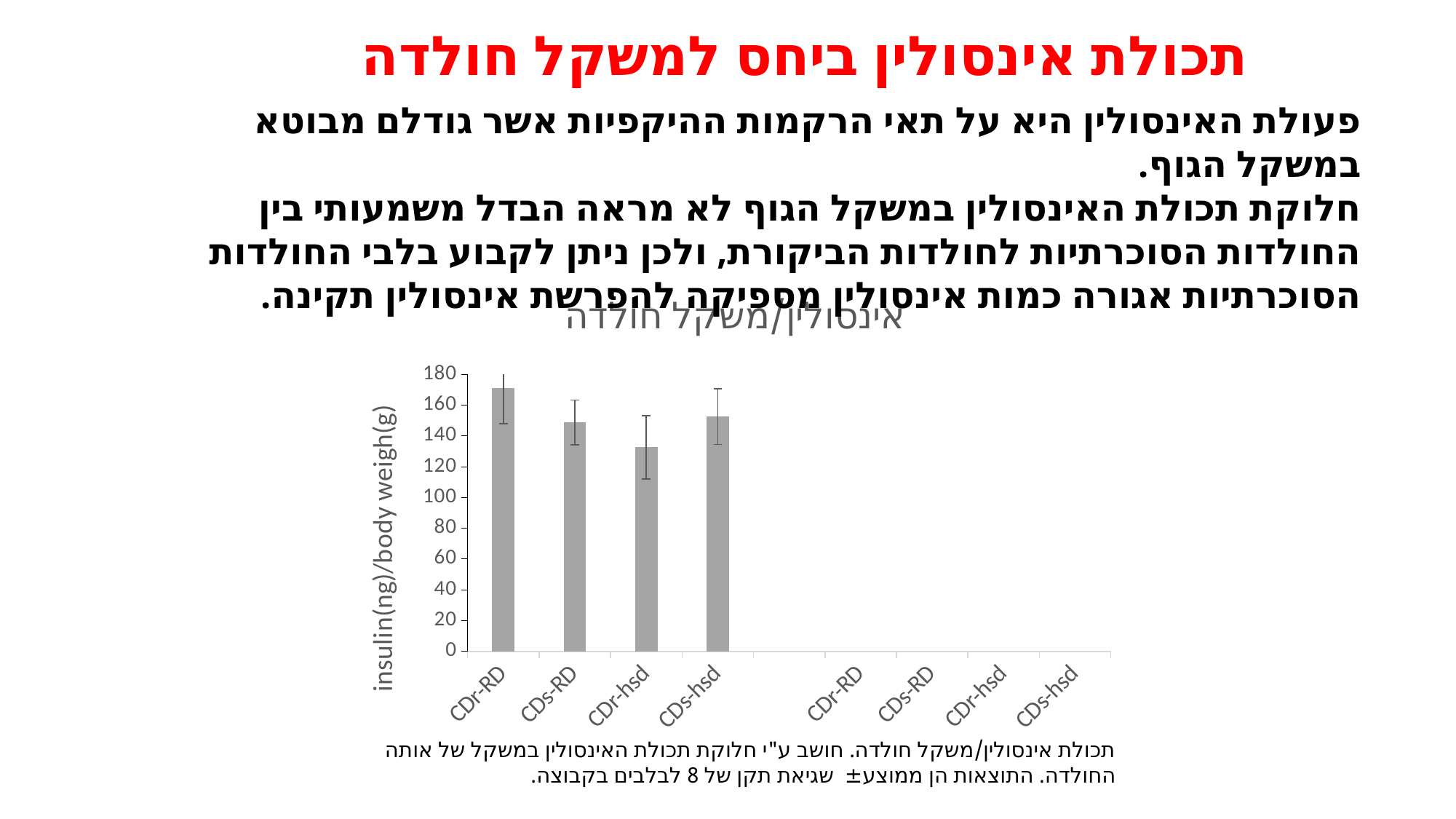
Is the value for CDr-RD greater or less than 160? greater What is the label of the vertical axis? insulin(ng)/body weigh(g) What is the maximum value shown on the vertical axis? 180 How many bars are plotted in the chart? 4 Is the value for CDs-RD greater or less than 140? greater Which category has the highest bar? CDr-RD What kind of chart is shown on the slide? bar chart Is the value for CDr-hsd greater or less than 140? less Which is larger, the value for CDs-RD or the value for CDr-hsd? CDs-RD Which category has the lowest bar among the plotted bars? CDr-hsd Which is larger, the value for CDr-RD or the value for CDr-hsd? CDr-RD